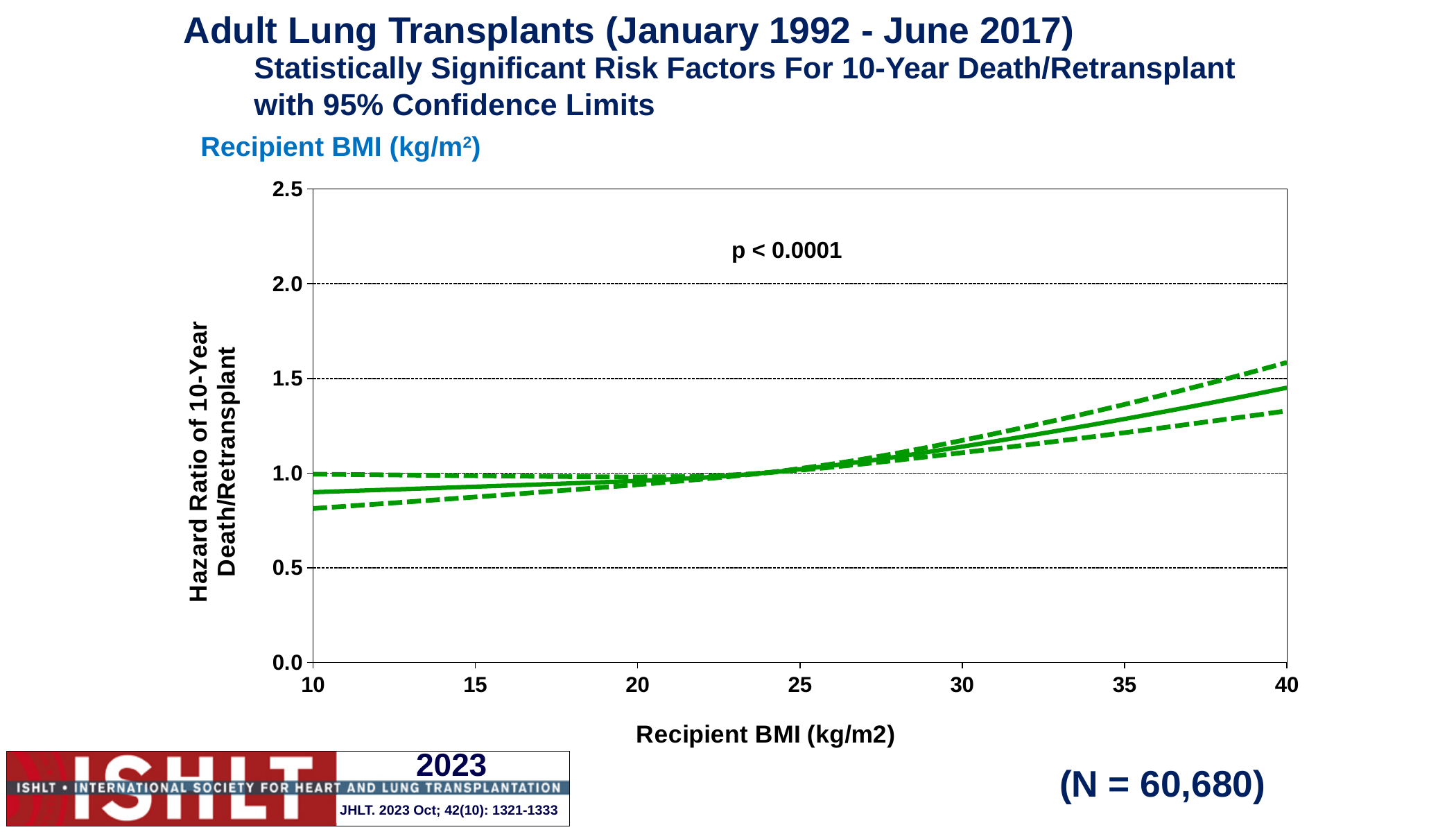
Is the lower 95% confidence limit (lower dashed line) at a recipient BMI of 10 greater or less than 1.0? less How many lines are plotted on the chart? 3 Is the hazard ratio (solid line) at a recipient BMI of 40 greater or less than 1.0? greater Does the hazard ratio rise or fall as recipient BMI increases from 10 to 40? rise Is the upper 95% confidence limit (upper dashed line) at a recipient BMI of 40 greater or less than 1.5? greater At which recipient BMI value on the x axis is the hazard ratio (solid line) highest? 40 What p-value is printed on the chart? p < 0.0001 What kind of chart is shown on the slide? line chart Which has the larger hazard ratio on the solid line: a recipient BMI of 10 or a recipient BMI of 40? 40 What is the label of the y axis? Hazard Ratio of 10-Year Death/Retransplant